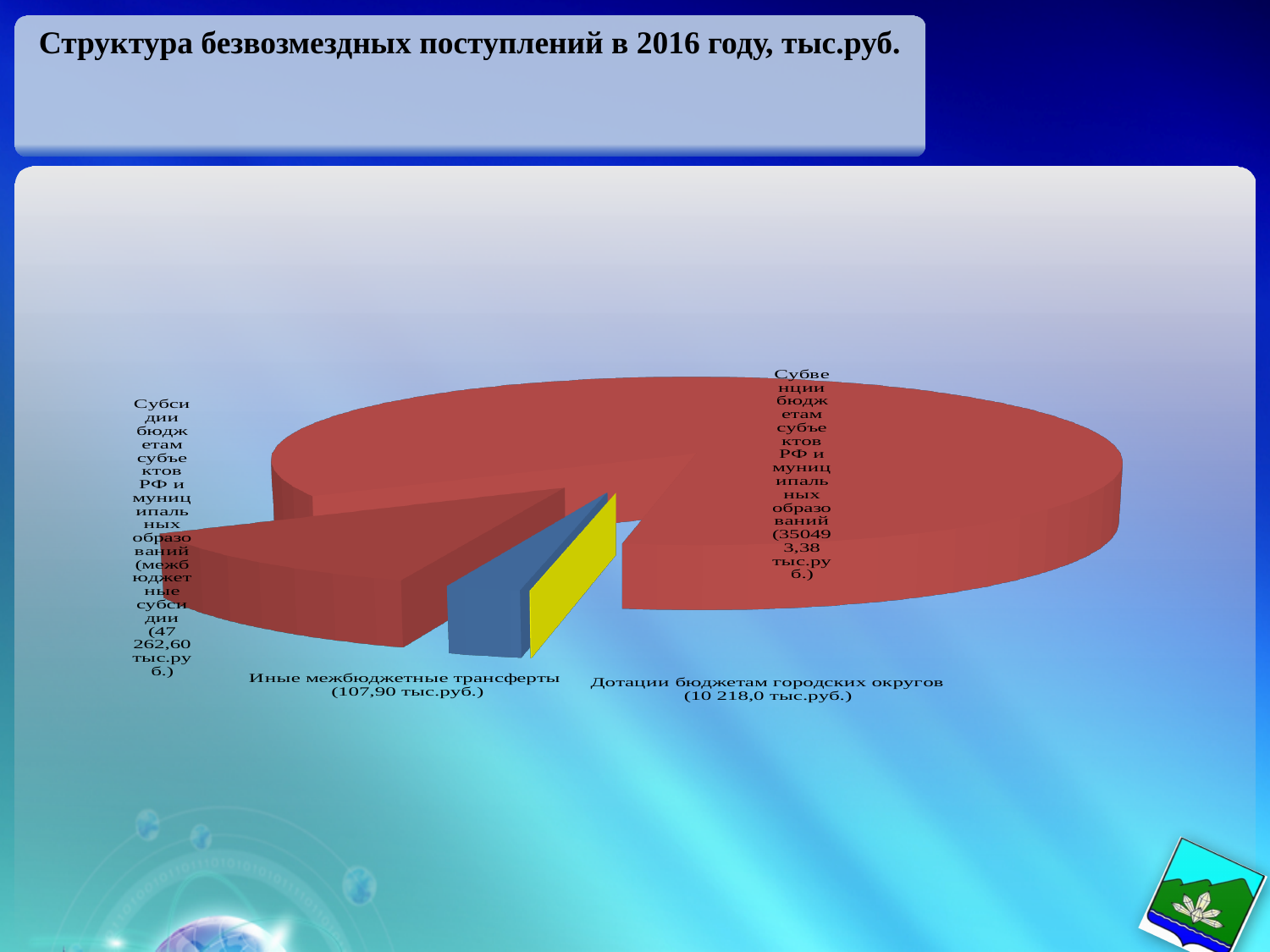
How many slices does the pie chart have? 4 Which is larger: Дотации бюджетам городских округов or Иные межбюджетные трансферты? Дотации бюджетам городских округов Which category has the smallest slice of the pie? Иные межбюджетные трансферты What is the difference between Субсидии (межбюджетные субсидии) and Дотации бюджетам городских округов? 37 044,60 тыс.руб. What is the value for Иные межбюджетные трансферты? 107,90 тыс.руб. What is the value for Дотации бюджетам городских округов? 10 218,0 тыс.руб. What colour is the slice for Дотации бюджетам городских округов? Yellow What is the title of the chart? Структура безвозмездных поступлений в 2016 году, тыс.руб. What is the value for Субсидии бюджетам субъектов РФ и муниципальных образований (межбюджетные субсидии)? 47 262,60 тыс.руб. Which category has the largest slice of the pie? Субвенции бюджетам субъектов РФ и муниципальных образований What is the value for Субвенции бюджетам субъектов РФ и муниципальных образований? 350493,38 тыс.руб. What kind of chart is shown on the slide? Pie chart